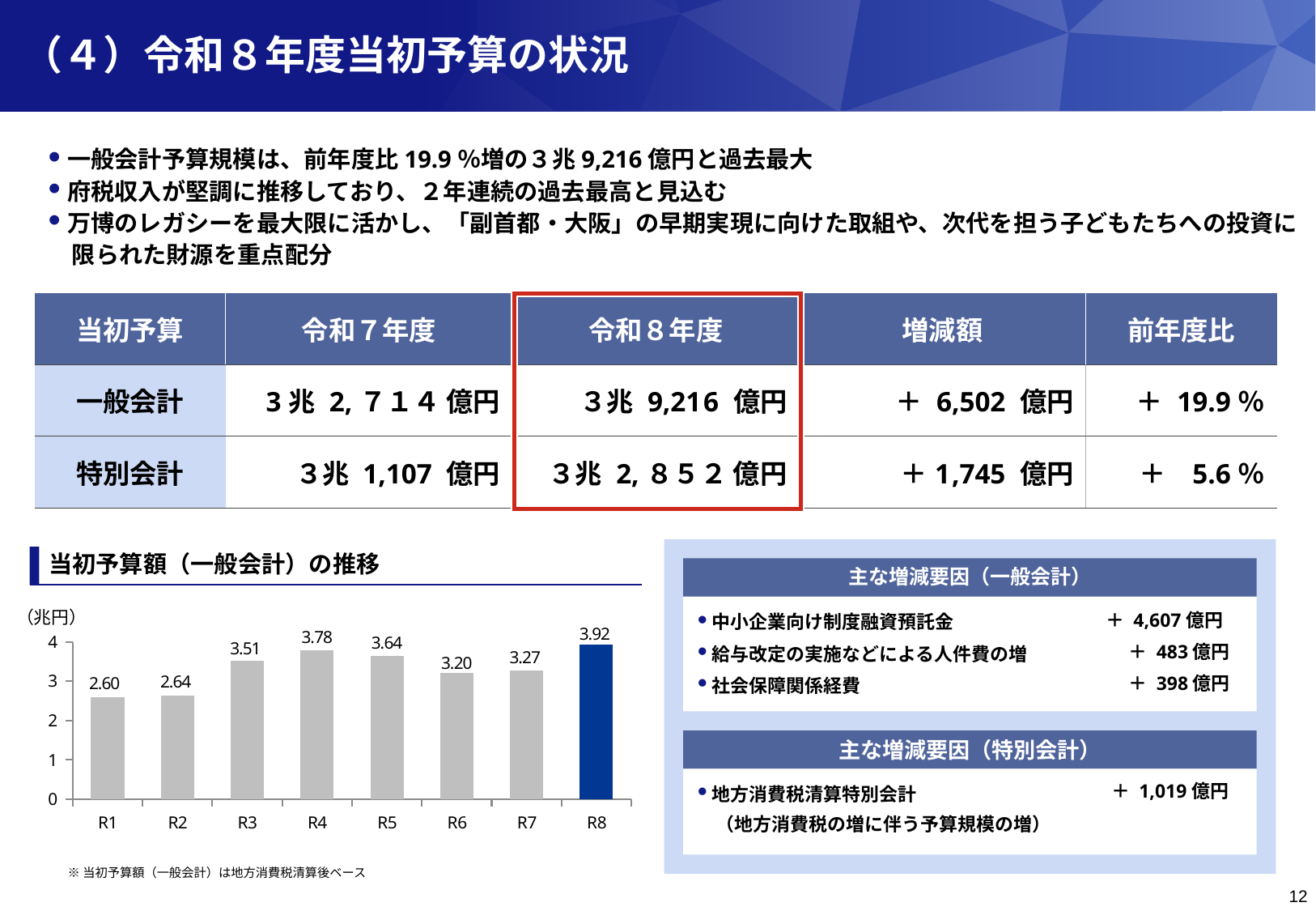
What is the difference between the R8 and R7 values in the 当初予算額（一般会計）の推移 chart? 0.65 How many years are plotted in the 当初予算額（一般会計）の推移 chart? 8 What unit is shown on the y axis of the 当初予算額（一般会計）の推移 chart? 兆円 What is the value for R4 in the 当初予算額（一般会計）の推移 chart? 3.78 Which year has the highest value in the 当初予算額（一般会計）の推移 chart? R8 What is the value for R8 in the 当初予算額（一般会計）の推移 chart? 3.92 In the 当初予算額（一般会計）の推移 chart, is the value for R3 greater or less than 3? greater In the 当初予算額（一般会計）の推移 chart, does the value rise or fall from R4 to R5? fall What is the value for R1 in the 当初予算額（一般会計）の推移 chart? 2.60 Which year has the lowest value in the 当初予算額（一般会計）の推移 chart? R1 In the 当初予算額（一般会計）の推移 chart, which is larger, the value for R5 or the value for R6? R5 What kind of chart is the 当初予算額（一般会計）の推移 chart? bar chart